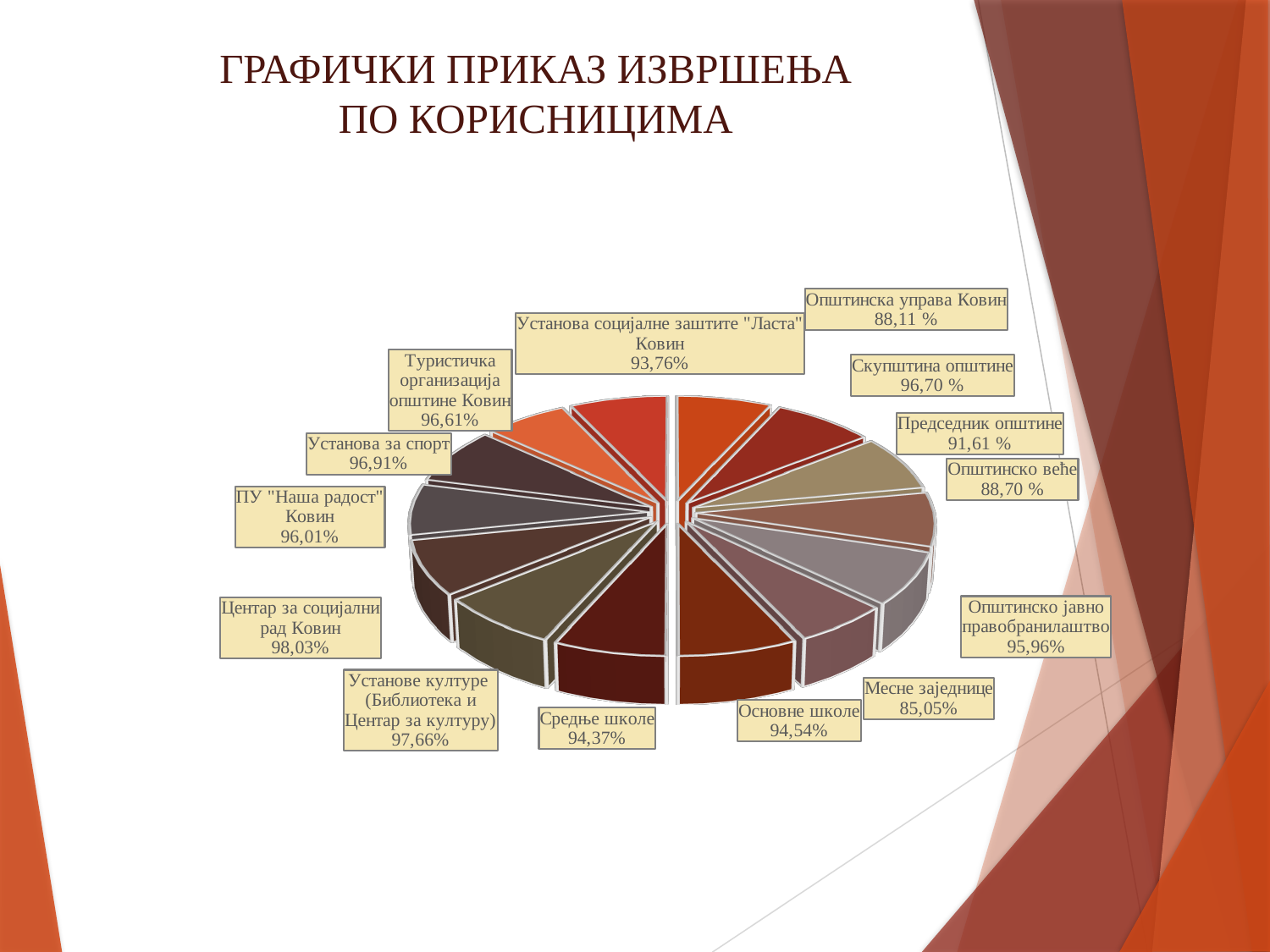
Which category has the highest labelled percentage? Центар за социјални рад Ковин What percentage is shown for Установа социјалне заштите "Ласта" Ковин? 93,76% Which has a higher labelled percentage, Скупштина општине or Председник општине? Скупштина општине What is the difference between the labelled percentages for Центар за социјални рад Ковин and Месне заједнице? 12,98% What is the title of the slide containing the chart? ГРАФИЧКИ ПРИКАЗ ИЗВРШЕЊА ПО КОРИСНИЦИМА What percentage is shown for Установе културе (Библиотека и Центар за културу)? 97,66% What kind of chart is shown on the slide? Pie chart What is the difference between the labelled percentages for Основне школе and Средње школе? 0,17% How many categories (slices) are labelled on the pie chart? 14 Which category has the lowest labelled percentage? Месне заједнице What percentage is shown for Општинска управа Ковин? 88,11 % What percentage is shown for Месне заједнице? 85,05%